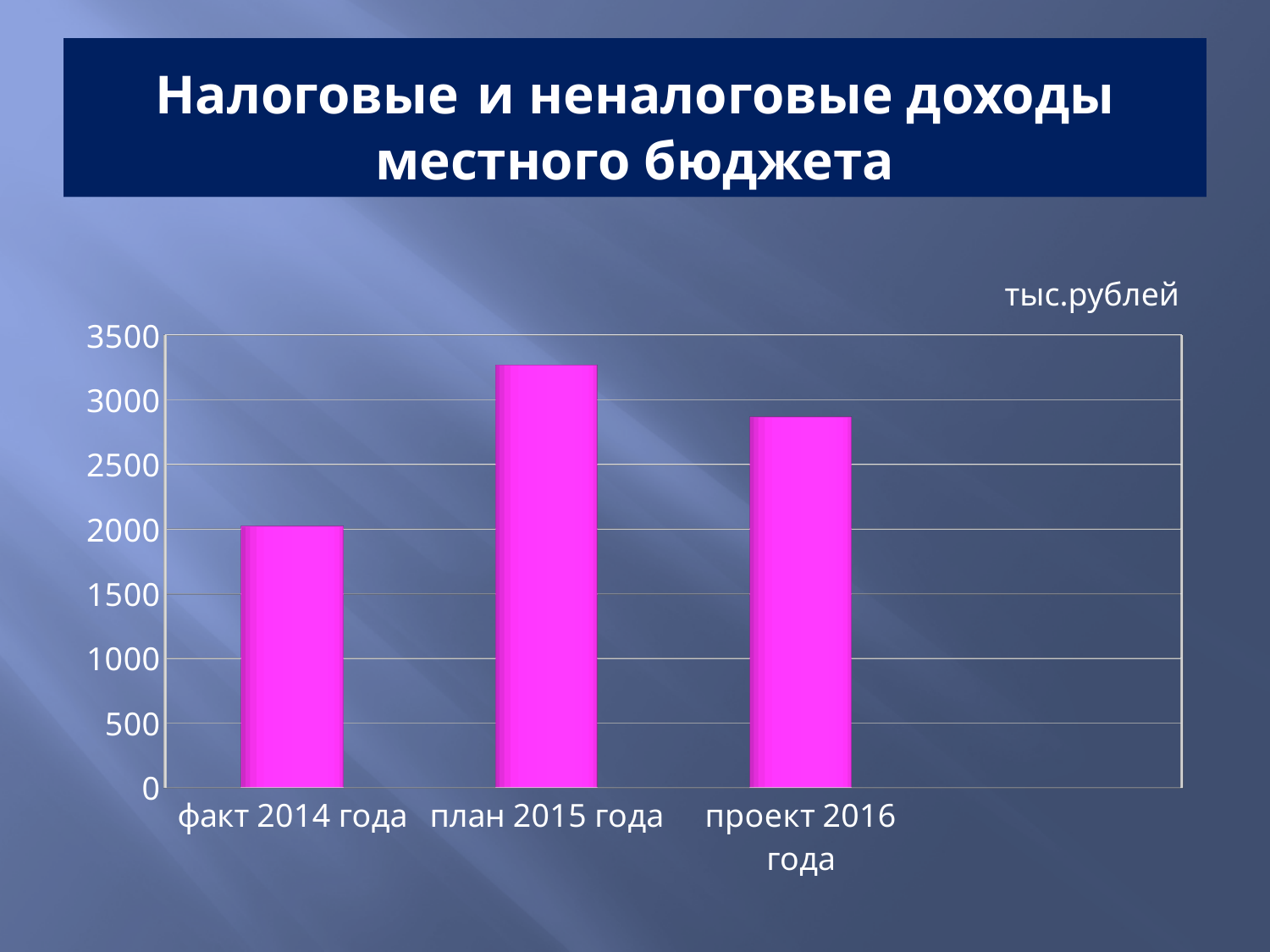
Which category has the highest value in the chart? план 2015 года What is the title of the slide containing the chart? Налоговые и неналоговые доходы местного бюджета Is the value for факт 2014 года greater or less than 2500? less Which is larger, the value for план 2015 года or the value for проект 2016 года? план 2015 года Which category has the lowest value in the chart? факт 2014 года Is the value for проект 2016 года greater or less than 3000? less How many categories are shown on the x axis of the chart? 3 Is the value for план 2015 года greater or less than 3000? greater What kind of chart is shown on the slide? bar chart What unit of measurement is indicated above the chart? тыс.рублей Which is larger, the value for факт 2014 года or the value for проект 2016 года? проект 2016 года